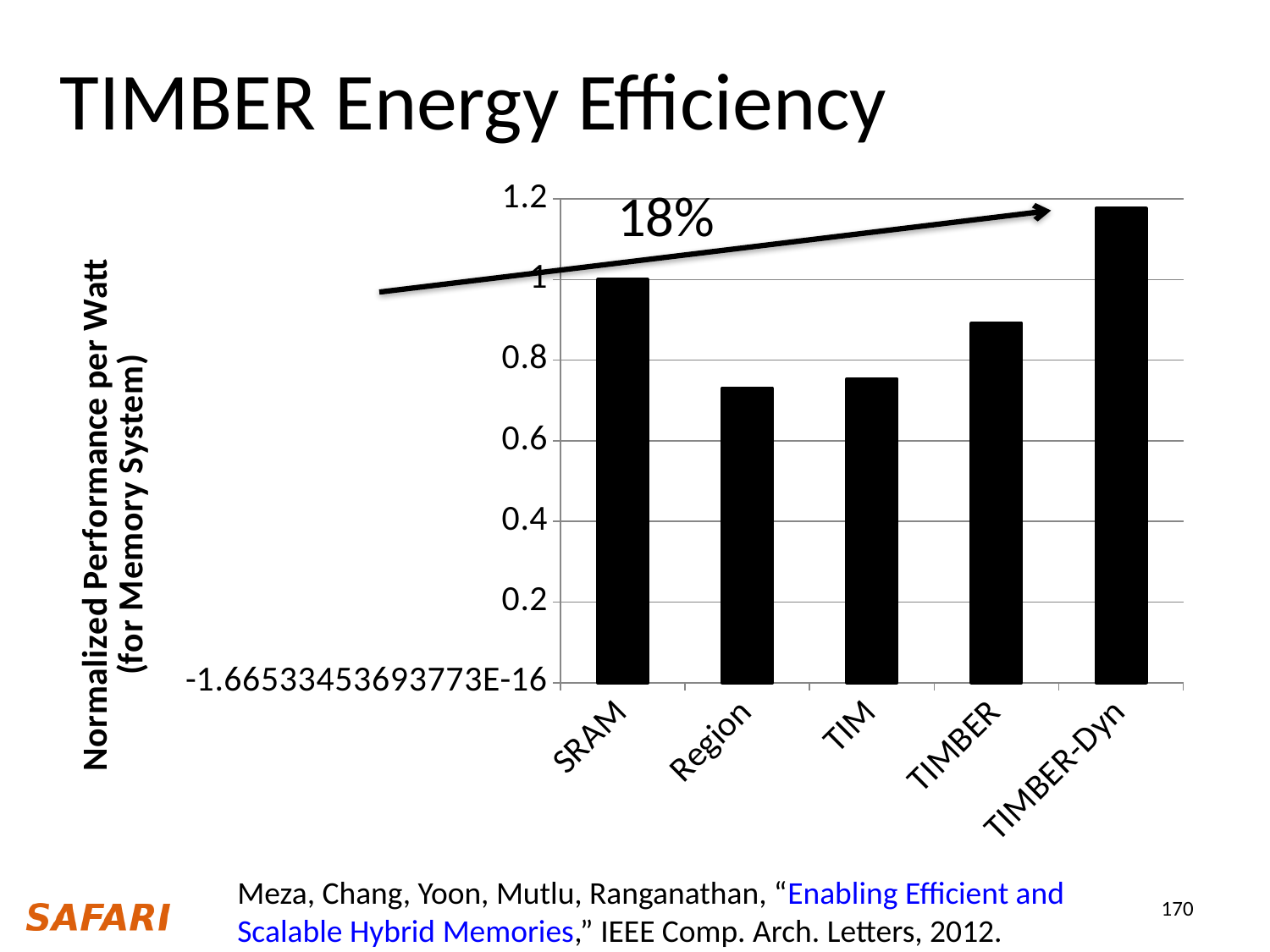
Is the value for TIMBER-Dyn greater or less than 1? greater What is the normalized performance per watt for SRAM? 1 Is the value for TIMBER greater or less than 0.8? greater Which has a higher normalized performance per watt, TIMBER or Region? TIMBER How many categories are plotted along the x axis? 5 What kind of chart is shown on the slide? bar chart Which category has the highest normalized performance per watt? TIMBER-Dyn What percentage improvement is annotated with the arrow on the chart? 18% Is the value for Region greater or less than 0.8? less What is the y-axis title of the chart? Normalized Performance per Watt (for Memory System) Which has a higher normalized performance per watt, SRAM or TIM? SRAM